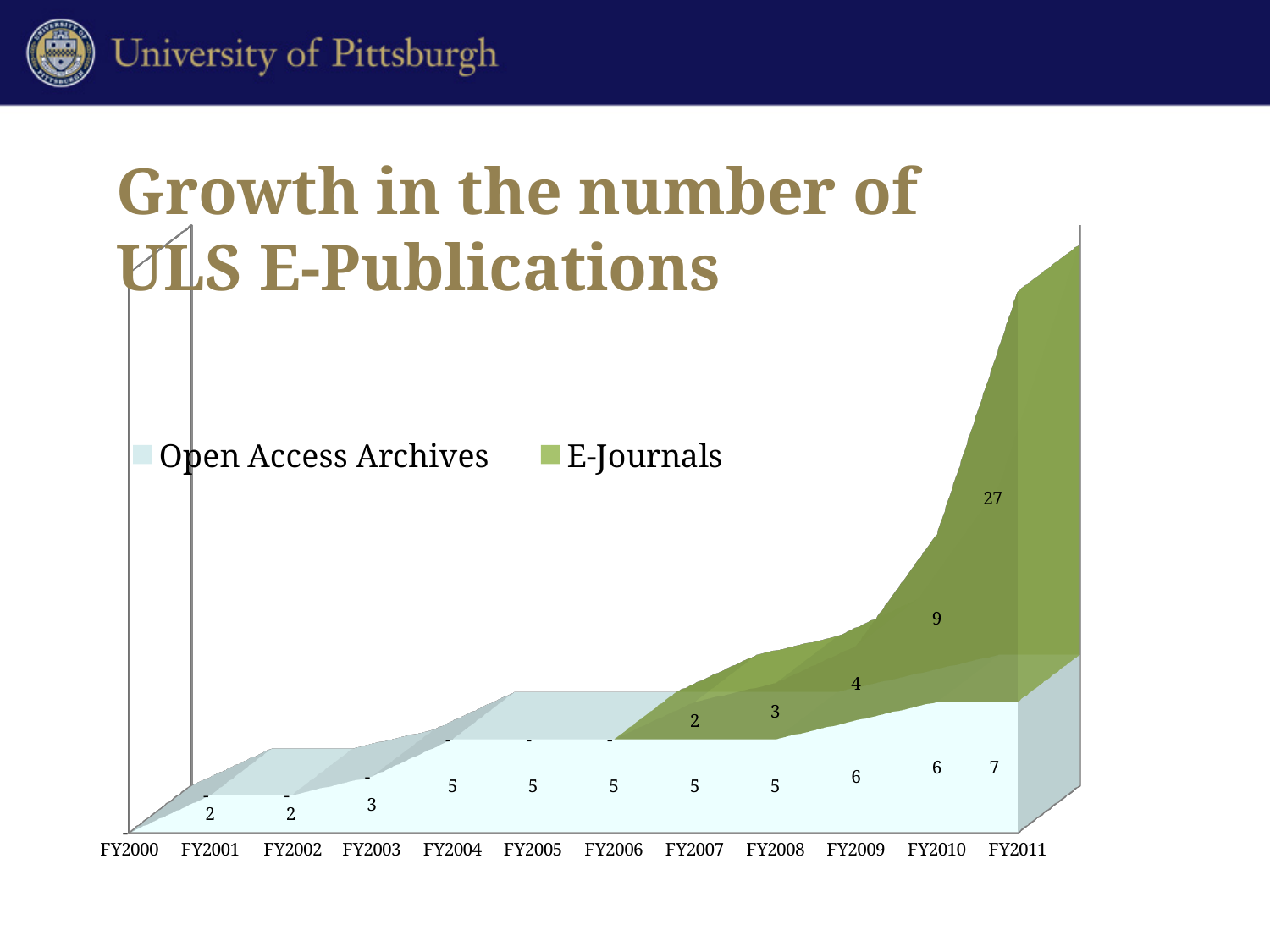
What is the value for E-Journals in FY2010? 9 What is the value for Open Access Archives in FY2003? 3 In which fiscal year is the E-Journals value highest? FY2011 What kind of chart is shown on the slide? Area chart How many fiscal years are shown on the x axis? 12 What is the difference between the E-Journals values for FY2011 and FY2010? 18 What is the value for Open Access Archives in FY2011? 7 What is the combined total of Open Access Archives and E-Journals in FY2011? 34 How many series does the legend list? 2 What is the value for E-Journals in FY2011? 27 Which series is shown in green in the legend? E-Journals Which is larger in FY2009: the Open Access Archives value or the E-Journals value? Open Access Archives